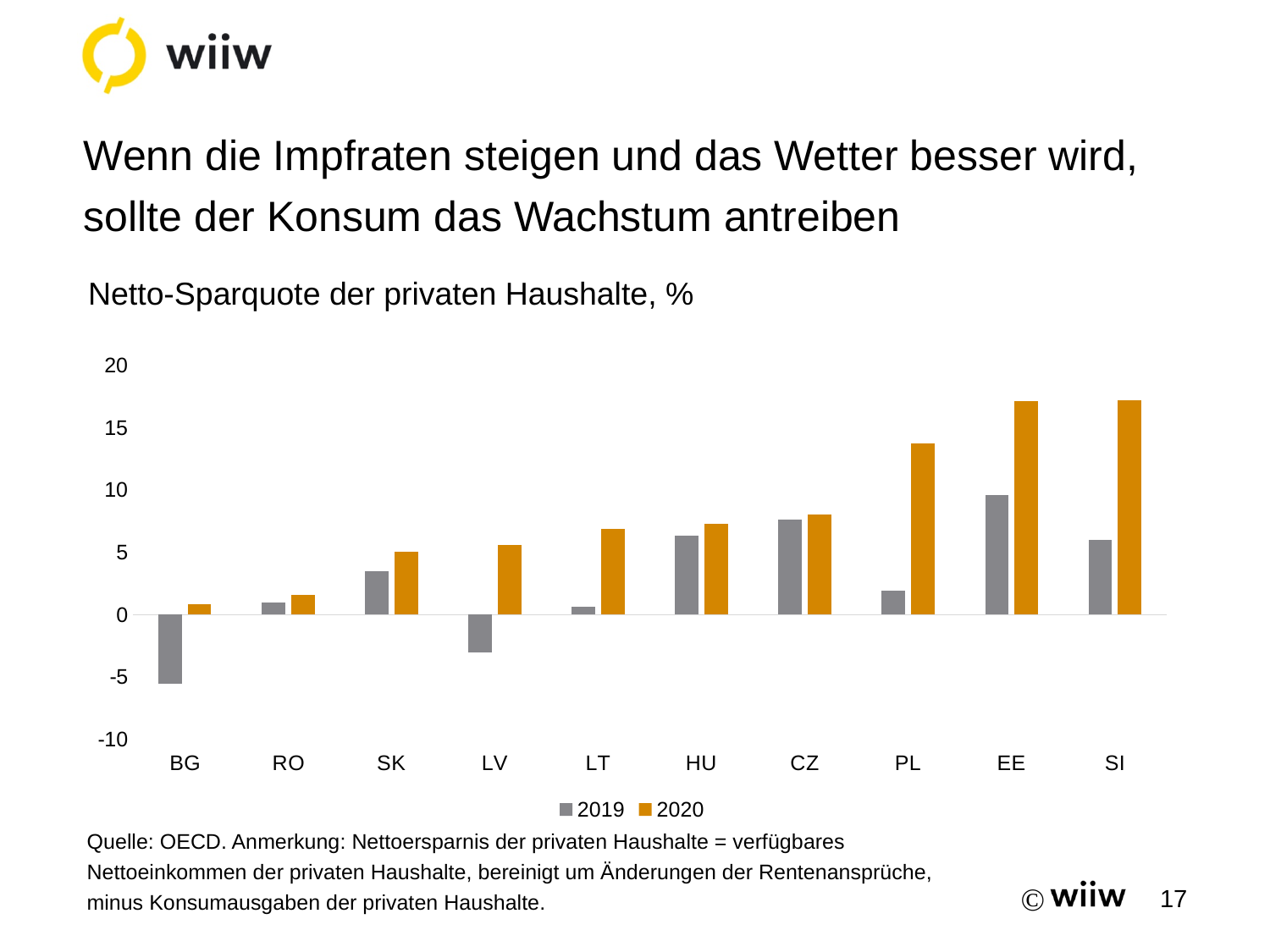
Is the 2020 value for PL greater or less than 10? greater Which country has the lowest value for 2019? BG Do the 2020 values generally rise or fall from BG on the left to SI on the right? rise Is the 2019 value for LV greater or less than 0? less Which country has the highest value for 2019? EE How many series does the legend list? 2 For PL, which is larger: the 2019 value or the 2020 value? 2020 What kind of chart is shown on the slide? bar chart Which is larger: the 2019 value for EE or the 2019 value for SI? EE Is the 2019 value for SK greater or less than 5? less How many countries are shown on the x axis of the chart? 10